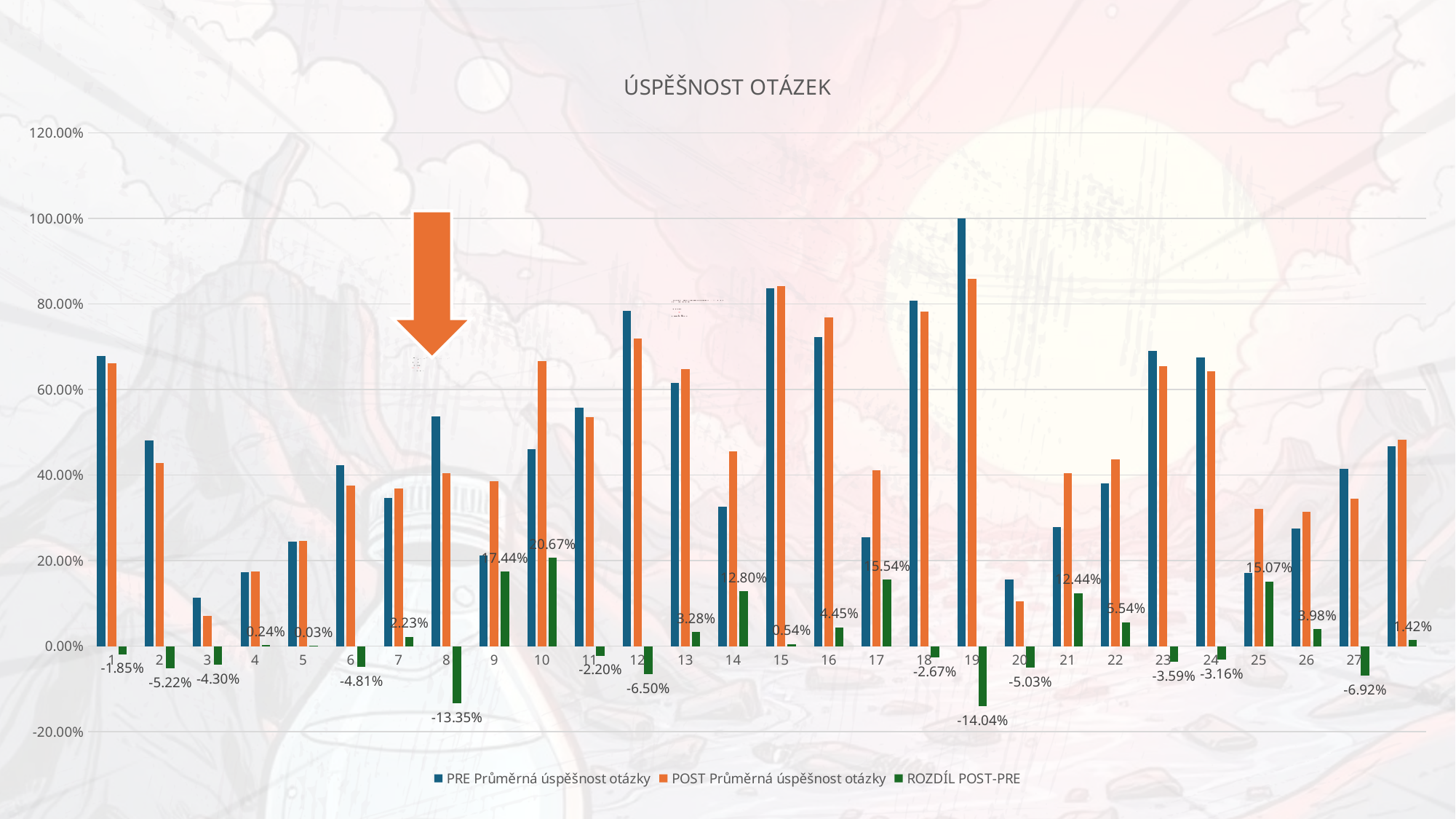
Which question has the highest PRE Průměrná úspěšnost otázky value? 19 What is the ROZDÍL POST-PRE value for question 8? -13.35% Which question has the highest ROZDÍL POST-PRE value? 10 What kind of chart is shown on the slide? bar chart Which is larger for question 9: the ROZDÍL POST-PRE value or the ROZDÍL POST-PRE value for question 17? question 9 (17.44%) What is the title of the chart? ÚSPĚŠNOST OTÁZEK What is the ROZDÍL POST-PRE value for question 10? 20.67% How many series does the legend list? 3 Is the POST Průměrná úspěšnost otázky value for question 3 greater or less than 20%? less Which question has the lowest ROZDÍL POST-PRE value? 19 What is the ROZDÍL POST-PRE value for question 19? -14.04% Is the PRE Průměrná úspěšnost otázky value for question 19 greater or less than 80%? greater